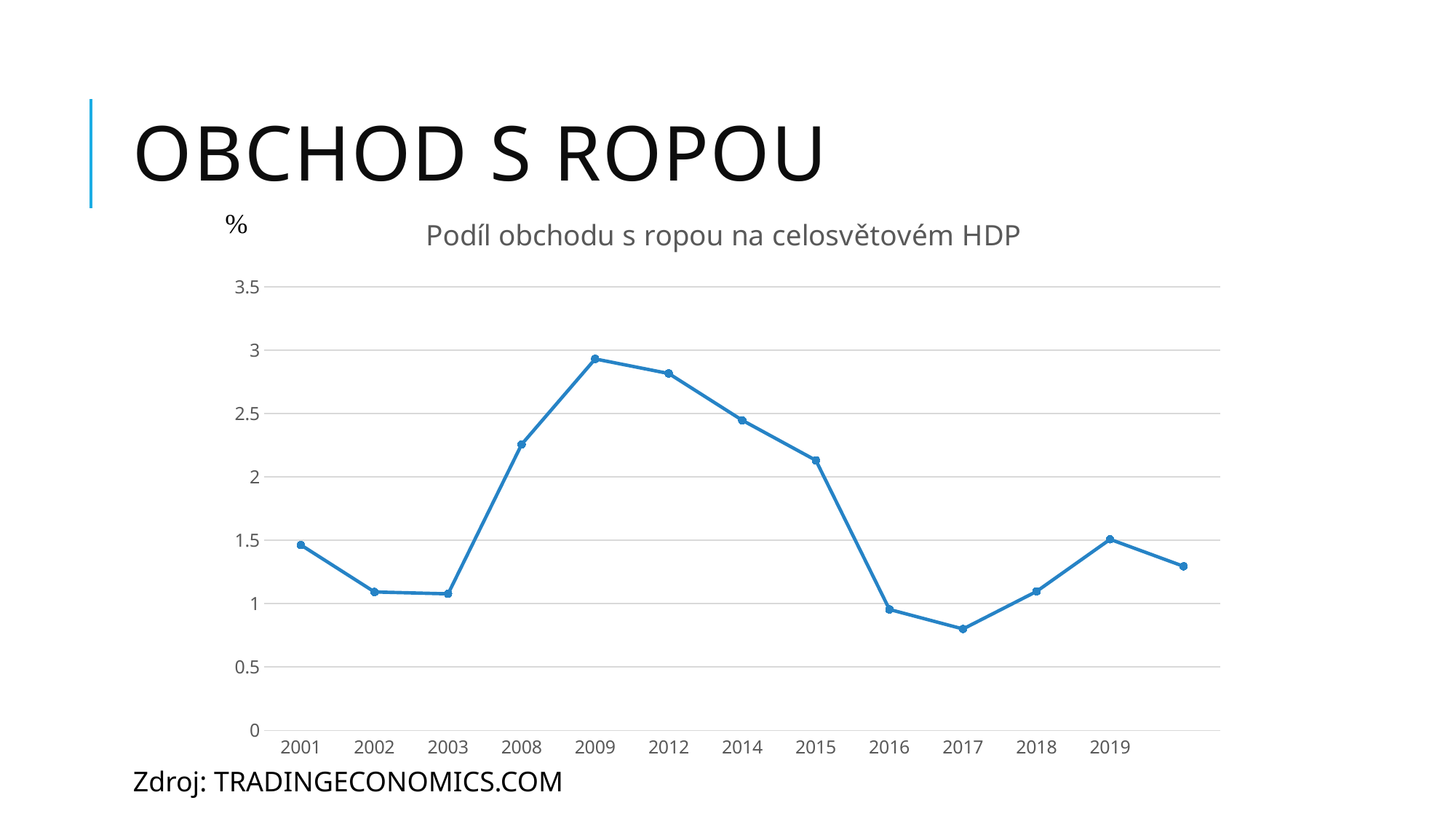
What unit is shown at the top of the vertical axis? % Which is larger, the value for 2018 or the value for 2019? 2019 Which year has the highest value on the chart? 2009 Which year has the lowest value on the chart? 2017 Which is larger, the value for 2001 or the value for 2002? 2001 What is the title of the chart? Podíl obchodu s ropou na celosvětovém HDP Is the value for 2008 greater or less than 2? greater Is the value for 2019 greater or less than 1? greater Do the values rise or fall from 2012 to 2017? fall Is the value for 2017 greater or less than 1? less What kind of chart is shown on the slide? line chart